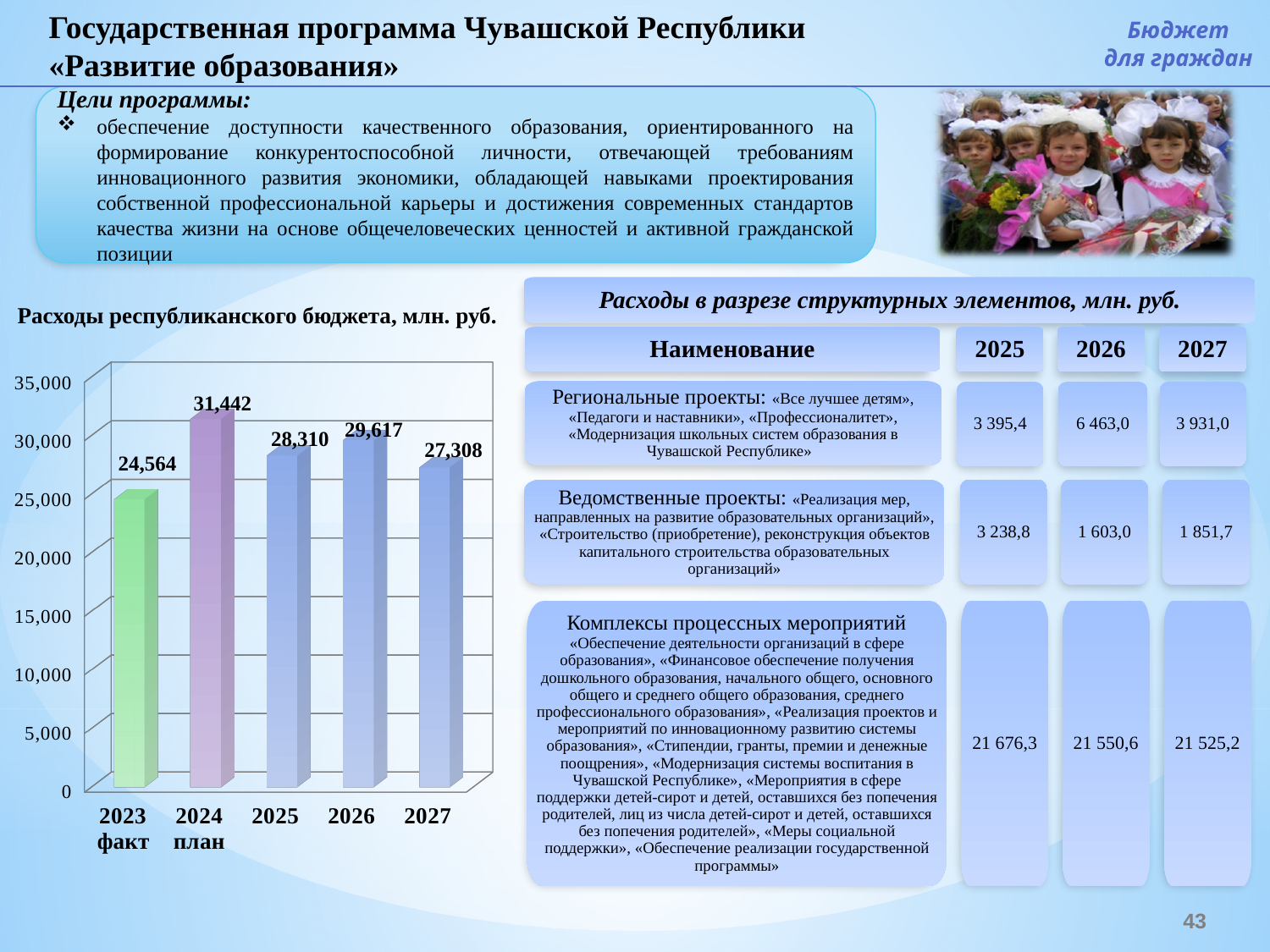
What is the difference between the values for 2026 and 2027 in the chart «Расходы республиканского бюджета, млн. руб.»? 2,309 Which year has the highest value in the chart «Расходы республиканского бюджета, млн. руб.»? 2024 план What is the value for 2026 in the chart «Расходы республиканского бюджета, млн. руб.»? 29,617 Which year has the lowest value in the chart «Расходы республиканского бюджета, млн. руб.»? 2023 факт How many bars are shown in the chart «Расходы республиканского бюджета, млн. руб.»? 5 Is the value for 2027 in the chart «Расходы республиканского бюджета, млн. руб.» greater or less than 25,000? greater What is the value for 2023 факт in the chart «Расходы республиканского бюджета, млн. руб.»? 24,564 Does the value rise or fall from 2024 план to 2025 in the chart «Расходы республиканского бюджета, млн. руб.»? fall What is the difference between the values for 2024 план and 2023 факт in the chart «Расходы республиканского бюджета, млн. руб.»? 6,878 Which is larger in the chart «Расходы республиканского бюджета, млн. руб.»: the value for 2025 or the value for 2026? 2026 What is the value for 2024 план in the chart «Расходы республиканского бюджета, млн. руб.»? 31,442 What type of chart is «Расходы республиканского бюджета, млн. руб.»? bar chart